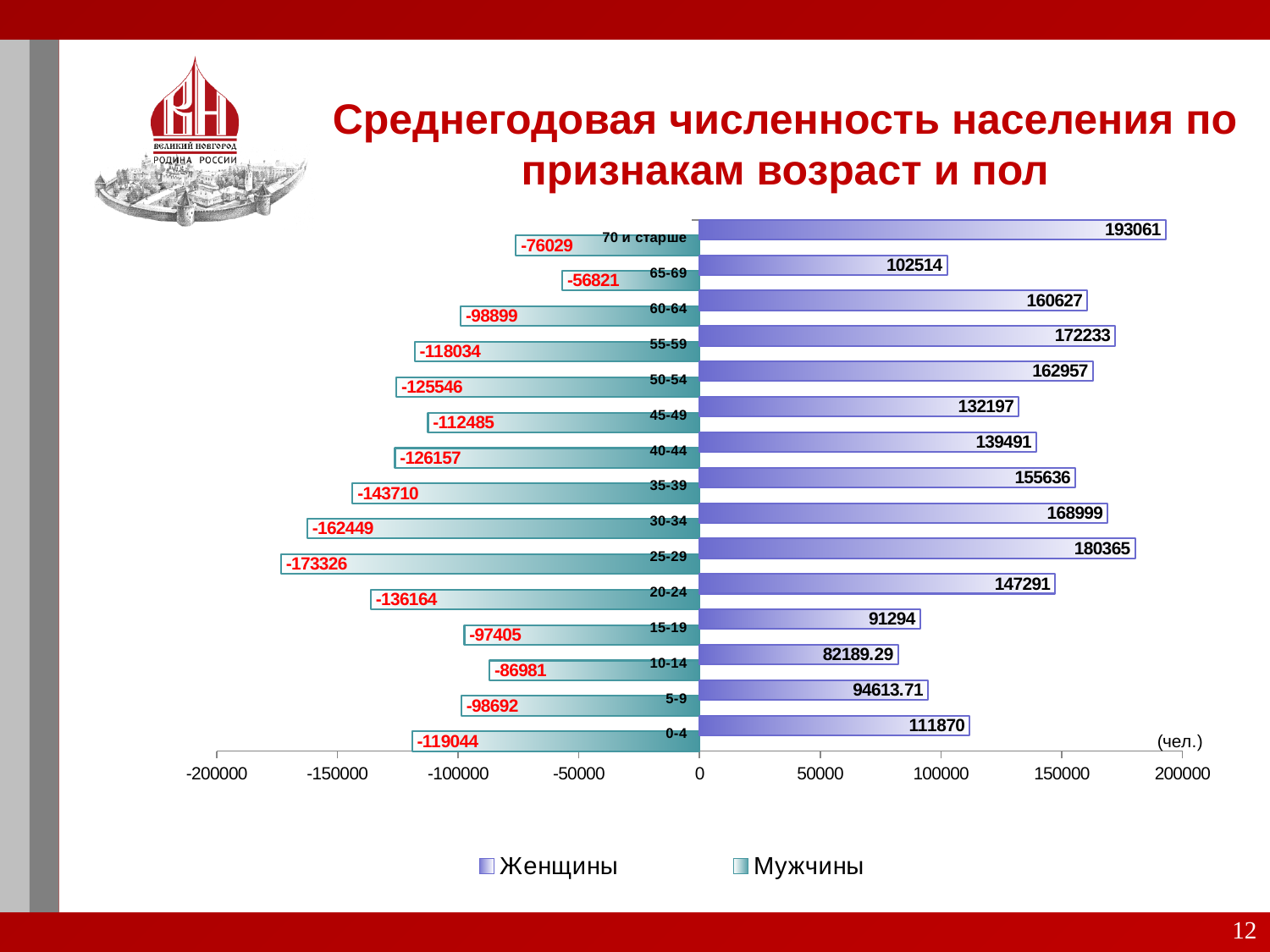
What is the value for Мужчины in the 0-4 age group? -119044 Which age group has the shortest bar for Мужчины? 65-69 Which age group has the highest value for Женщины? 70 и старше What type of chart is shown on the slide? bar chart How many age categories are shown on the chart? 15 Which age group has the longest bar for Мужчины? 25-29 What is the difference between the Женщины values for the 70 и старше and 65-69 age groups? 90547 How many series does the legend list? 2 What is the value for Женщины in the 10-14 age group? 82189.29 Which age group has the lowest value for Женщины? 10-14 Which series is shown in blue according to the legend? Женщины What is the value for Женщины in the 25-29 age group? 180365